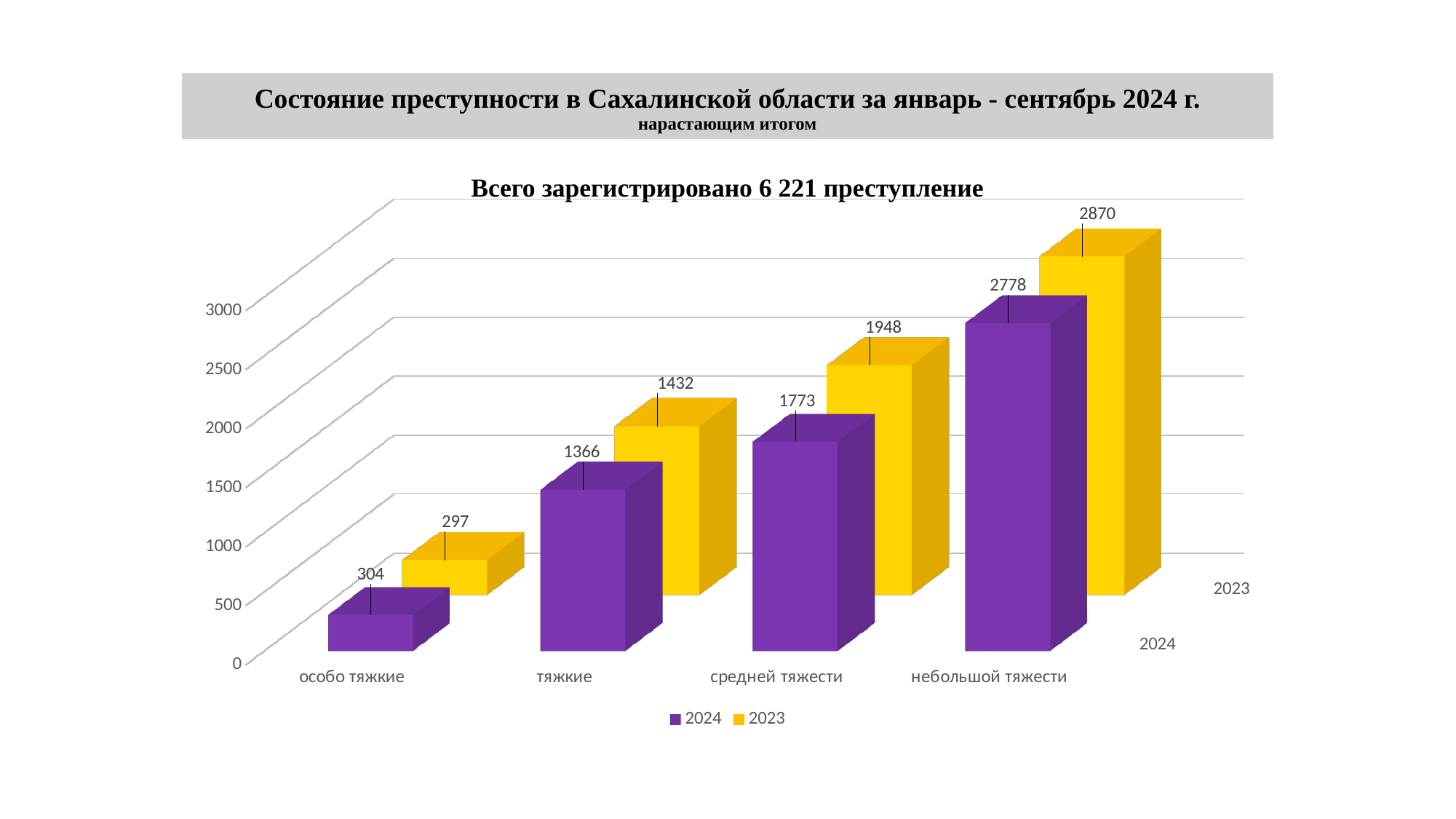
What is the difference between the 2023 and 2024 values for "средней тяжести"? 175 What is the value for "небольшой тяжести" in the 2023 series? 2870 What is the value for "тяжкие" in the 2024 series? 1366 What is the chart's title? Всего зарегистрировано 6 221 преступление For "тяжкие", which series has the larger value, 2024 or 2023? 2023 Which category has the lowest value in the 2023 series? особо тяжкие What kind of chart is shown on the slide? bar chart Do the values in the 2024 series rise or fall from left to right along the x axis? rise Which category has the highest value in the 2024 series? небольшой тяжести How many categories are shown on the x axis? 4 How many series does the legend list? 2 What is the value for "особо тяжкие" in the 2023 series? 297